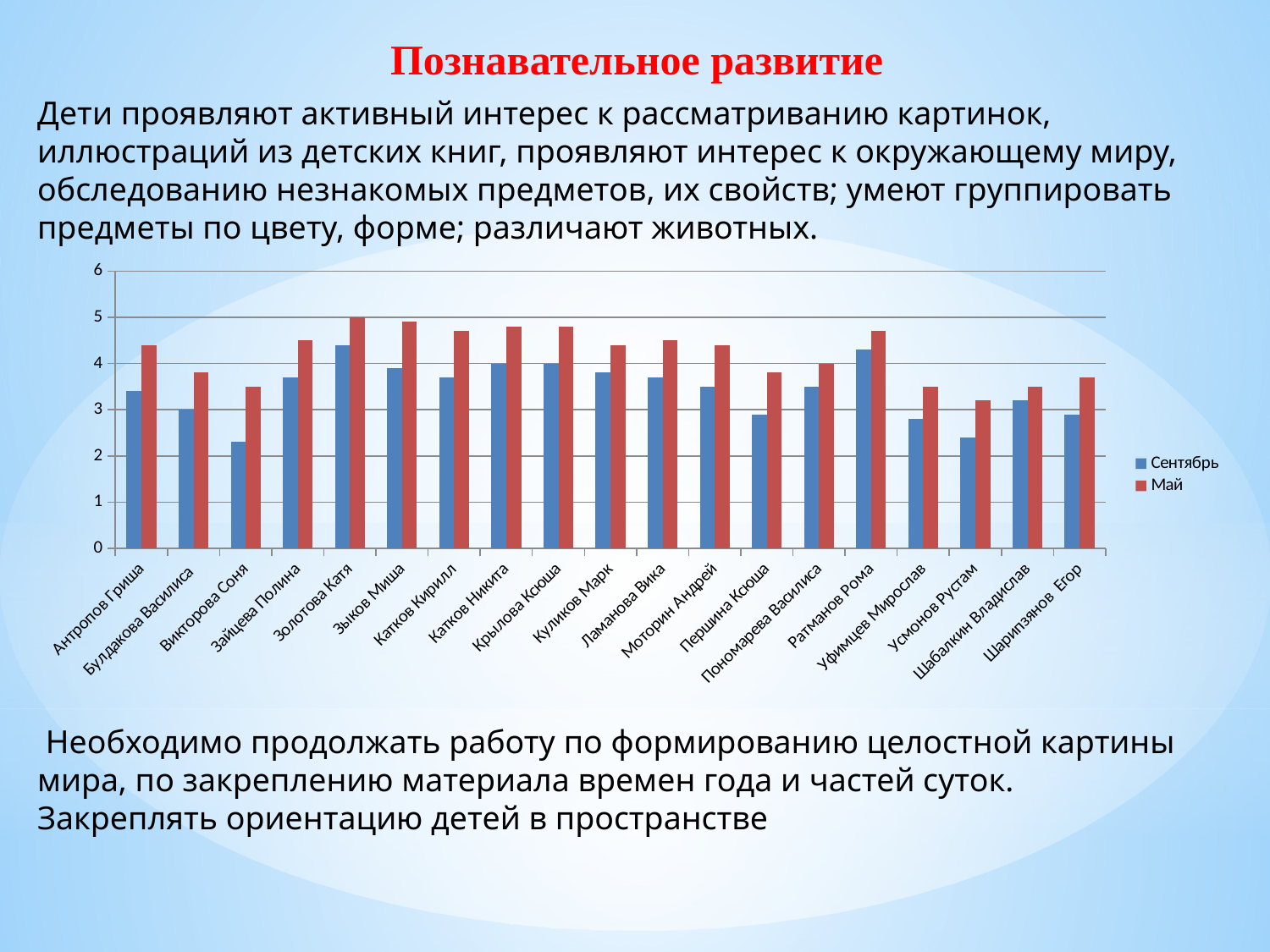
Is the Май value for Золотова Катя greater or less than 4? greater For Антропов Гриша, which is larger: the Сентябрь value or the Май value? Май Which series has the higher value for Першина Ксюша, Сентябрь or Май? Май Is the Сентябрь value for Викторова Соня greater or less than 3? less What kind of chart is shown on the slide? bar chart What are the two series named in the chart legend? Сентябрь and Май Is the Сентябрь value for Уфимцев Мирослав greater or less than 3? less How many children (categories) are shown on the x axis of the chart? 19 How many series does the chart legend list? 2 Which colour represents the Май series in the chart? red Which child has the highest Май value in the chart? Золотова Катя